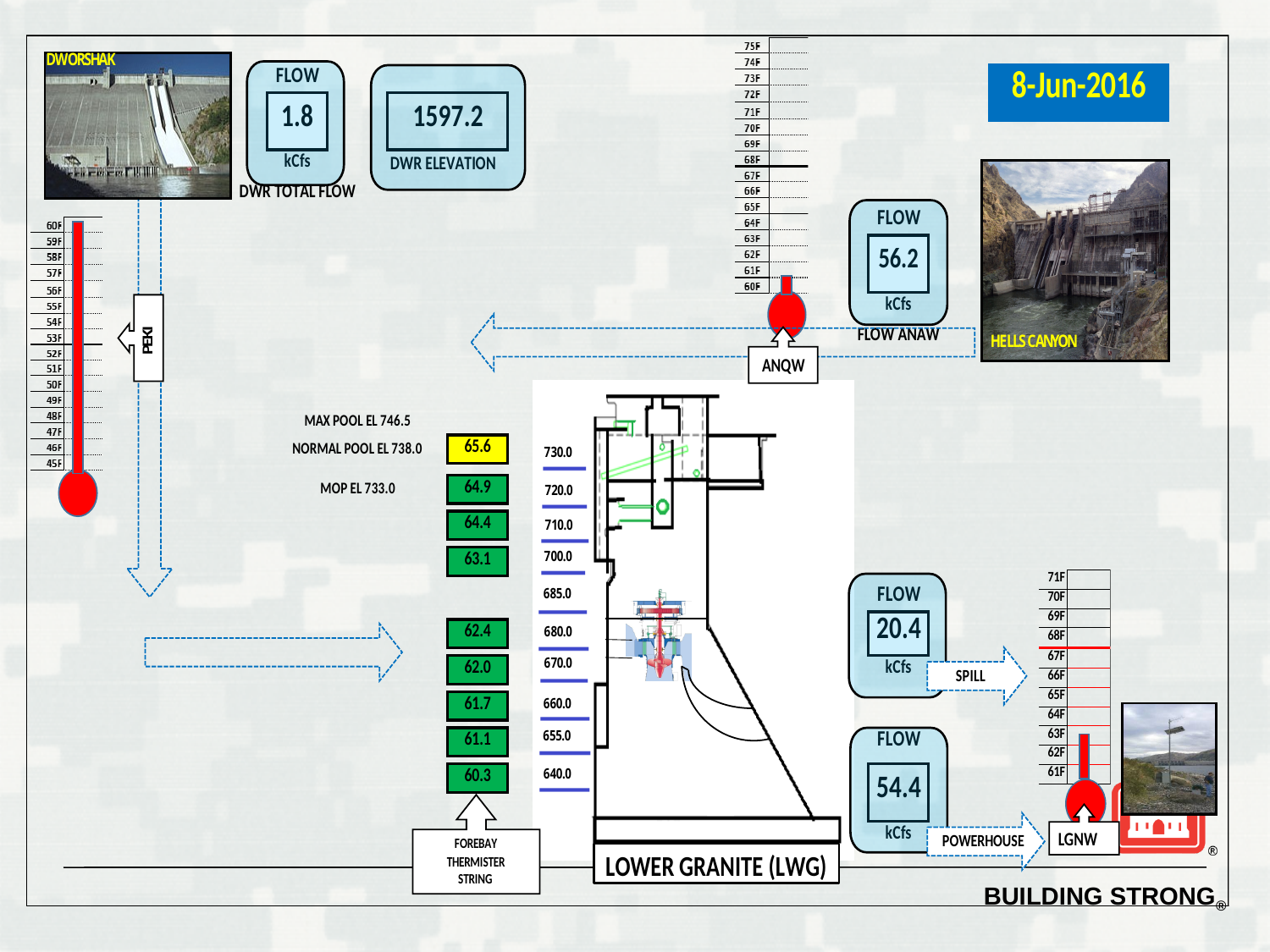
What is the highest temperature value shown in the forebay thermistor string? 65.6 What is the spill flow value shown for Lower Granite? 20.4 kCfs What is the flow value shown for Hells Canyon (FLOW ANAW)? 56.2 kCfs On the ANQW thermometer gauge, is the marked temperature greater or less than 65F? greater What is the DWR elevation value shown? 1597.2 Which is larger at Lower Granite, the spill flow or the powerhouse flow? Powerhouse flow On the PEKI thermometer gauge, is the marked temperature greater or less than 55F? less What is the lowest temperature value shown in the forebay thermistor string? 60.3 What is the powerhouse flow value shown for Lower Granite? 54.4 kCfs How many temperature values are listed in the forebay thermistor string? 9 What is the difference between the top (65.6) and bottom (60.3) values of the forebay thermistor string? 5.3 What is the DWR total flow value shown for Dworshak? 1.8 kCfs